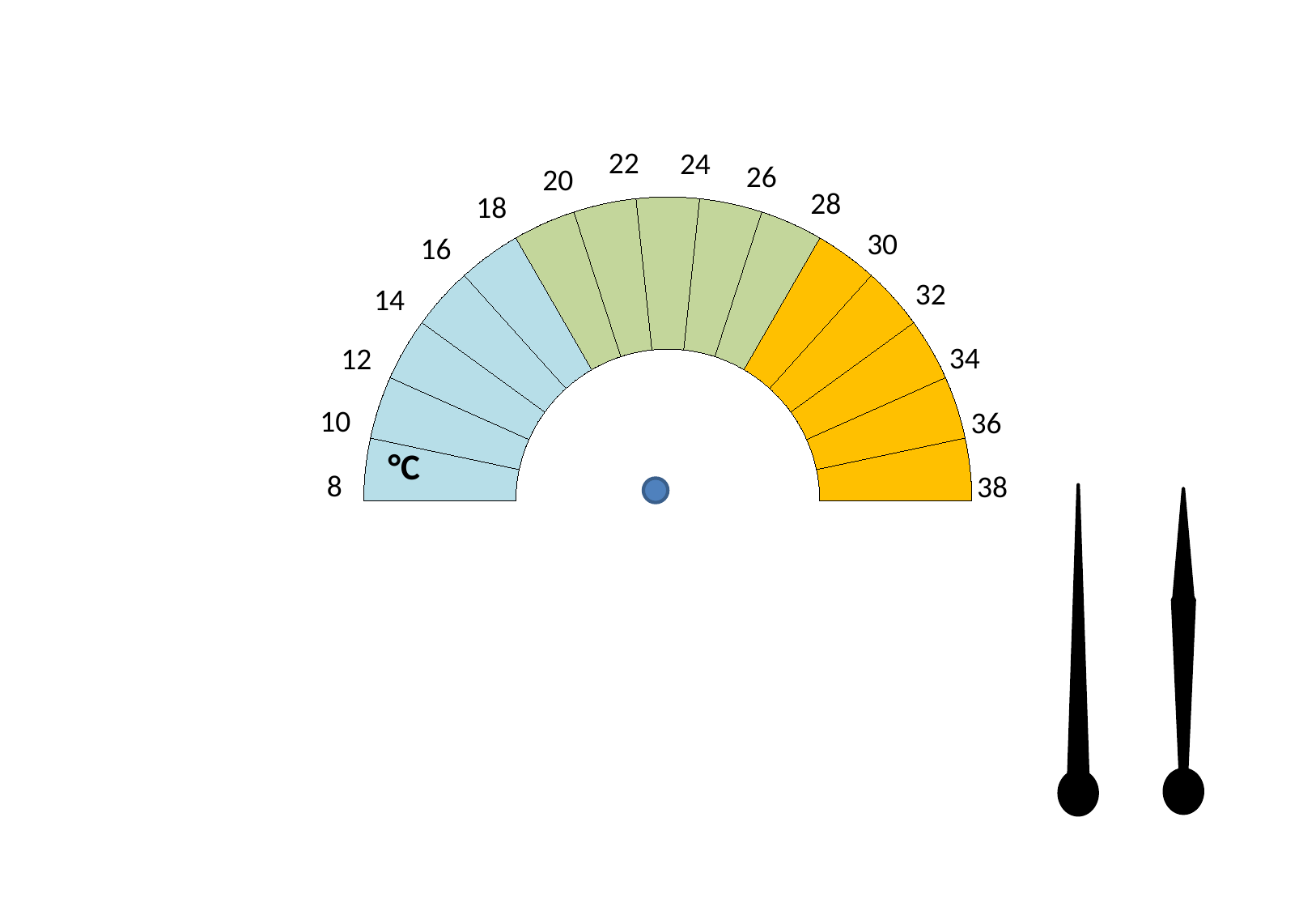
Which tick label is larger, the one at the start of the orange band or the one at the start of the green band? the start of the orange band (28) By how much do consecutive tick labels on the gauge increase? 2 What is the highest value labelled on the gauge scale? 38 What unit is printed on the gauge? °C How many coloured bands does the gauge have? 3 Do the tick values increase or decrease going clockwise from left to right around the gauge? increase What is the lowest value labelled on the gauge scale? 8 What colour is the band covering the lowest values on the gauge? light blue How many numbered tick labels are shown around the gauge? 16 What kind of chart is shown on the slide? gauge chart